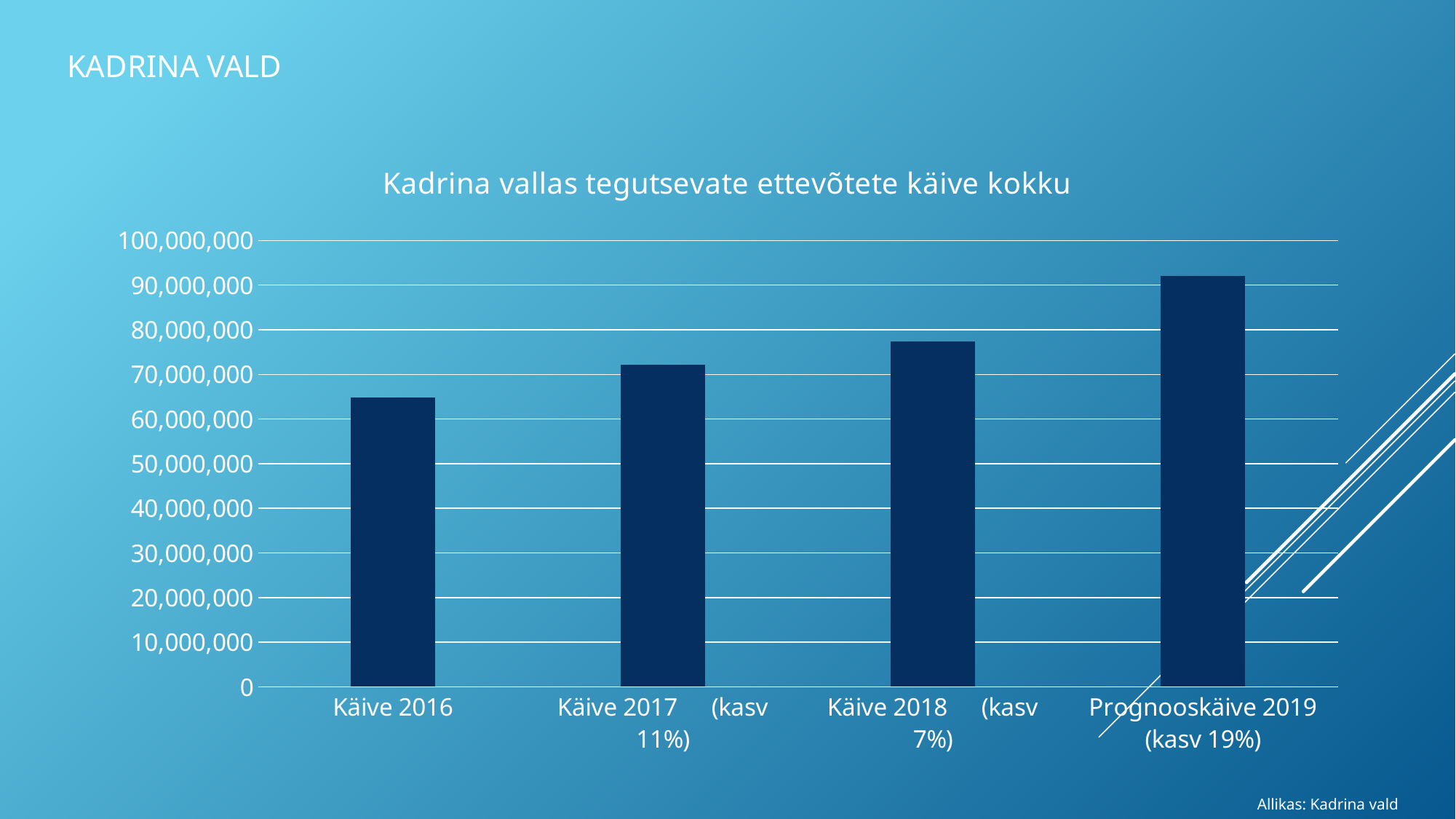
What source is cited at the bottom of the slide? Allikas: Kadrina vald Is the value for Käive 2018 (kasv 7%) greater or less than 70,000,000? greater Is the value for Prognooskäive 2019 (kasv 19%) greater or less than 90,000,000? greater Which category has the lowest value? Käive 2016 Which category has the highest value? Prognooskäive 2019 (kasv 19%) Do the values rise or fall from Käive 2016 to Prognooskäive 2019? rise How many bars does the chart show? 4 What is the title of the chart? Kadrina vallas tegutsevate ettevõtete käive kokku Is the value for Käive 2017 (kasv 11%) greater or less than 80,000,000? less Which is larger, the value for Käive 2017 (kasv 11%) or the value for Käive 2018 (kasv 7%)? Käive 2018 (kasv 7%) What kind of chart is shown on the slide? bar chart